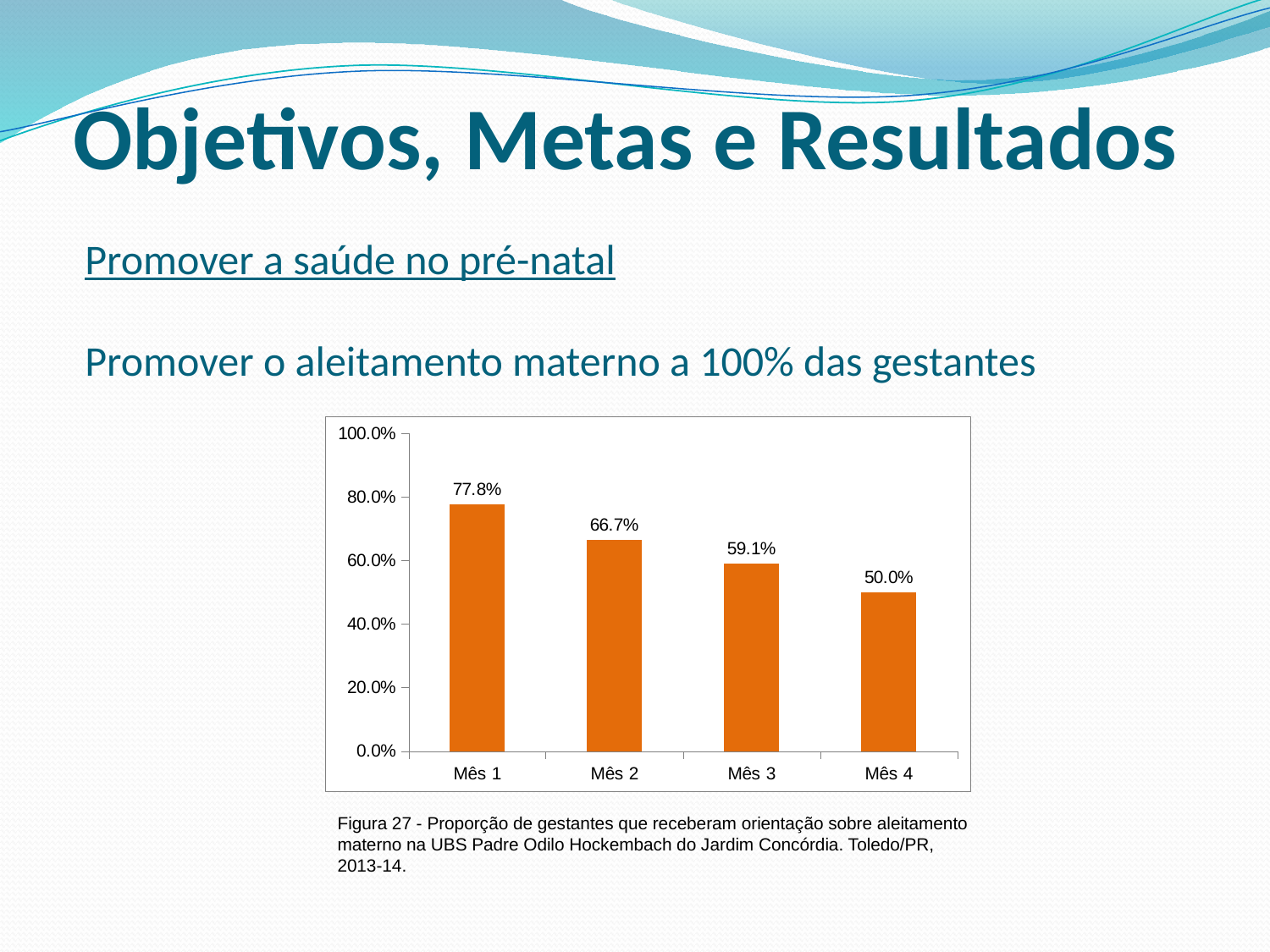
Do the values rise or fall from Mês 1 to Mês 4? fall Which month has the lowest value? Mês 4 Which month has the highest value? Mês 1 What is the value for Mês 4? 50.0% What is the value for Mês 3? 59.1% What is the difference between the values for Mês 1 and Mês 2? 11.1% What is the difference between the values for Mês 3 and Mês 4? 9.1% Which is larger, the value for Mês 2 or the value for Mês 3? Mês 2 Is the value for Mês 2 greater or less than 60.0%? greater What is the value for Mês 1? 77.8% What kind of chart is shown on the slide? bar chart How many months are shown on the x axis? 4